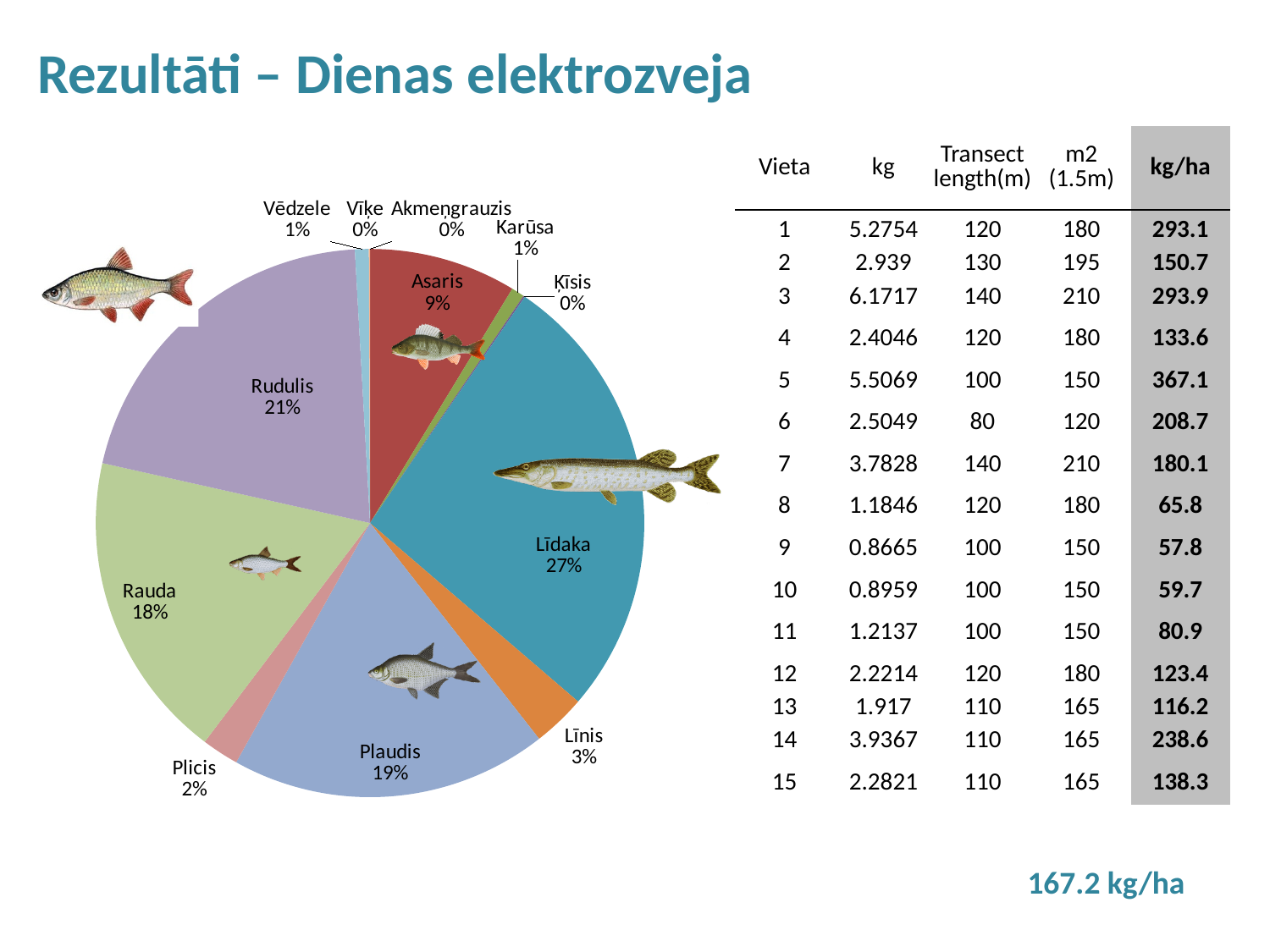
In the pie chart, which slice is larger, Rudulis or Plaudis? Rudulis In the pie chart, what share does Plaudis have? 19% In the pie chart, what share does Rauda have? 18% Which species has the largest slice in the pie chart? Līdaka In the pie chart, what share does Rudulis have? 21% In the pie chart, what is the difference in percentage points between Līdaka and Rauda? 9 What kind of chart is shown on the left of the slide? pie chart How many species are labelled in the pie chart? 12